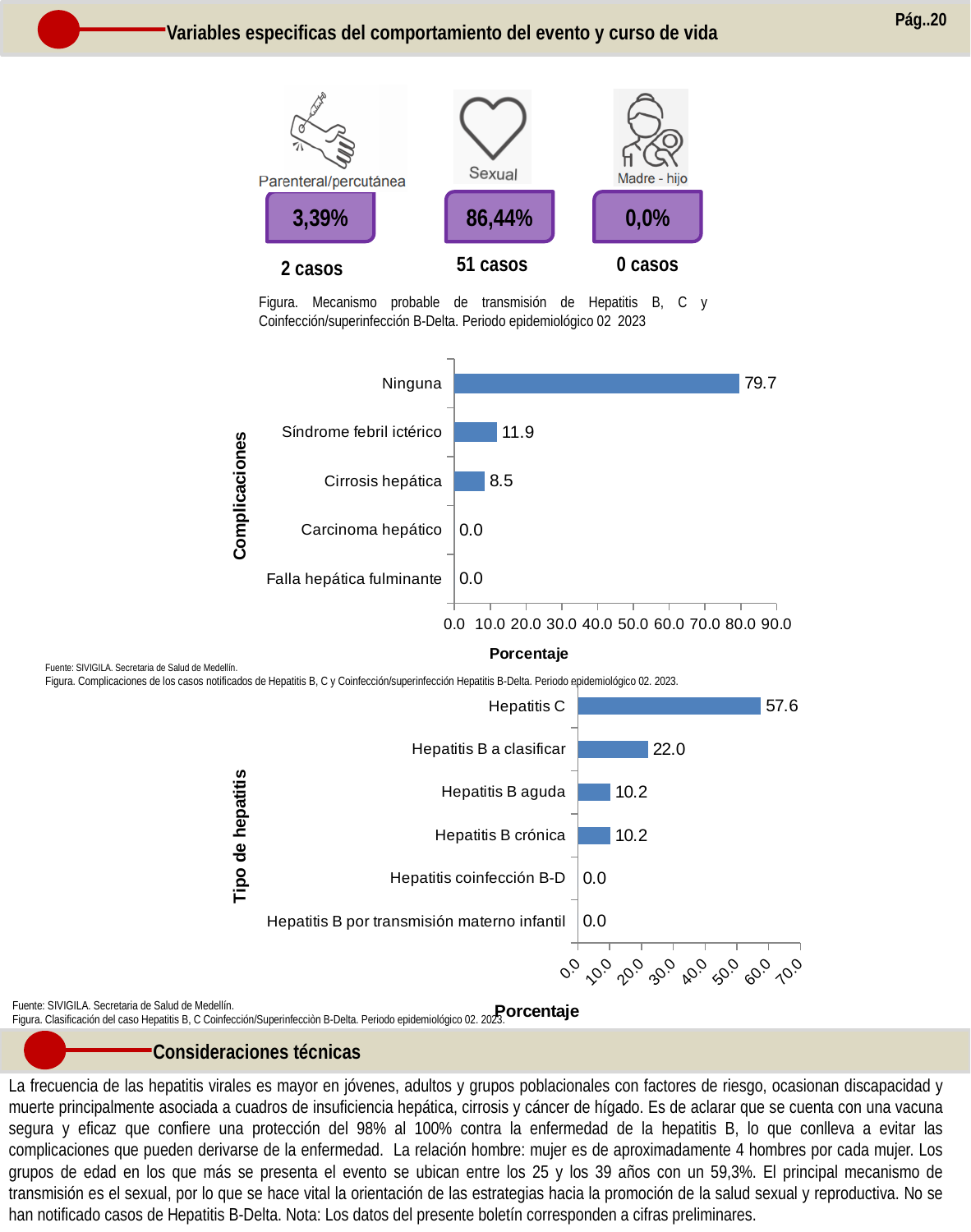
In the Tipo de hepatitis chart, how many categories are shown? 6 In the Complicaciones chart, what is the difference between Síndrome febril ictérico and Cirrosis hepática? 3.4 In the Complicaciones chart, what is the label of the x axis? Porcentaje In the Complicaciones chart, which category has the highest value? Ninguna In the Tipo de hepatitis chart, what is the value for Hepatitis B a clasificar? 22.0 In the Tipo de hepatitis chart, which is larger, Hepatitis B a clasificar or Hepatitis B aguda? Hepatitis B a clasificar In the Complicaciones chart, how many categories are shown? 5 In the Tipo de hepatitis chart, what is the value for Hepatitis C? 57.6 In the Complicaciones chart, what is the value for Ninguna? 79.7 In the Tipo de hepatitis chart, what is the difference between Hepatitis C and Hepatitis B a clasificar? 35.6 In the Complicaciones chart, what is the value for Síndrome febril ictérico? 11.9 What type of chart is the Tipo de hepatitis chart? Bar chart